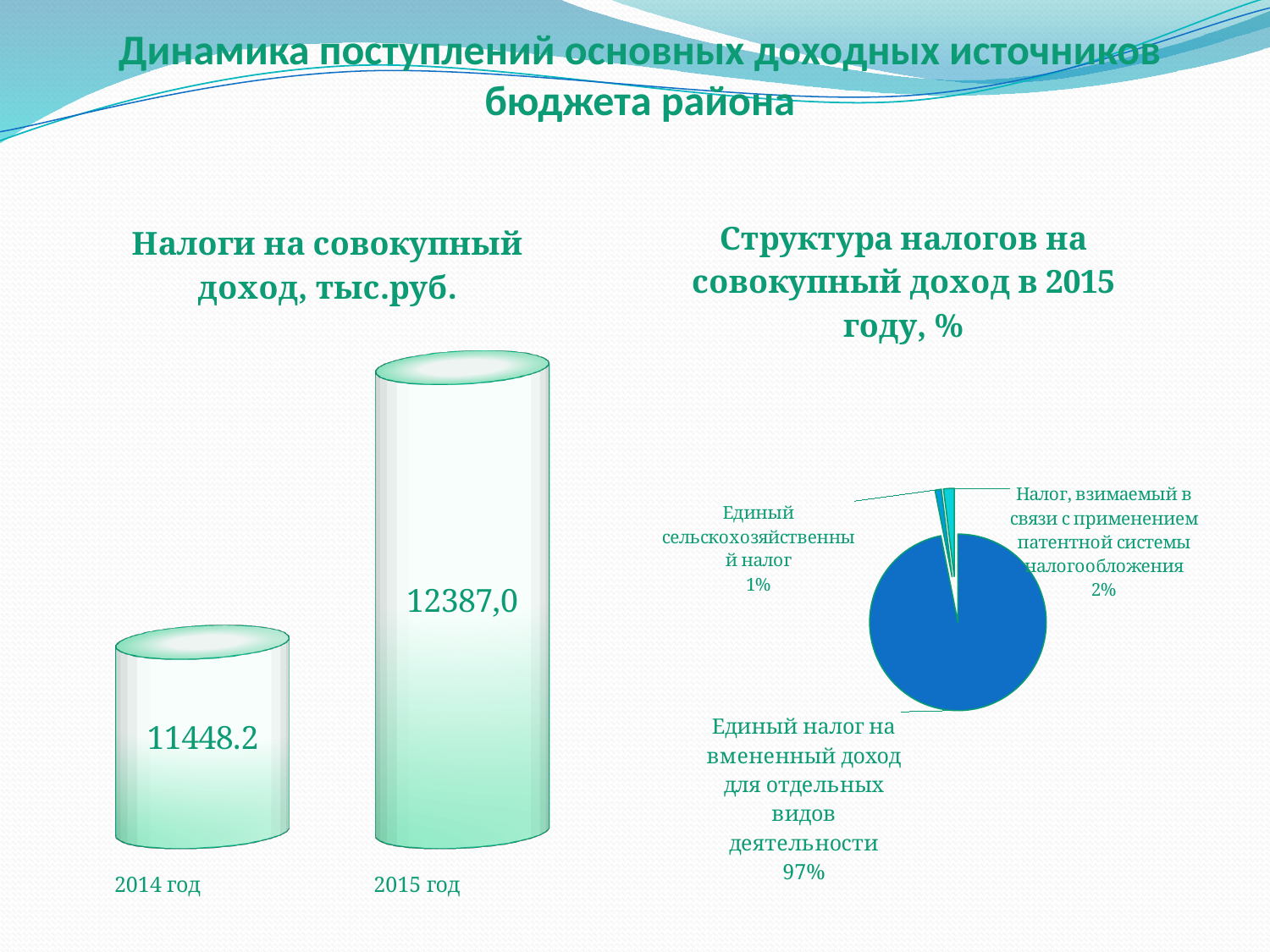
In the chart titled 'Налоги на совокупный доход, тыс.руб.', what is the value for 2015 год? 12387,0 What kind of chart is the one titled 'Структура налогов на совокупный доход в 2015 году, %'? pie chart In the chart titled 'Налоги на совокупный доход, тыс.руб.', what is the value for 2014 год? 11448.2 In the chart titled 'Налоги на совокупный доход, тыс.руб.', how many categories are shown? 2 In the chart titled 'Налоги на совокупный доход, тыс.руб.', which year has the higher value? 2015 год In the pie chart titled 'Структура налогов на совокупный доход в 2015 году, %', how many slices are there? 3 In the pie chart titled 'Структура налогов на совокупный доход в 2015 году, %', what share does 'Налог, взимаемый в связи с применением патентной системы налогообложения' have? 2% In the pie chart titled 'Структура налогов на совокупный доход в 2015 году, %', what share does 'Единый сельскохозяйственный налог' have? 1% What kind of chart is the one titled 'Налоги на совокупный доход, тыс.руб.'? bar chart In the pie chart titled 'Структура налогов на совокупный доход в 2015 году, %', what share does 'Единый налог на вмененный доход для отдельных видов деятельности' have? 97% In the chart titled 'Налоги на совокупный доход, тыс.руб.', do the values rise or fall from 2014 to 2015? rise In the chart titled 'Налоги на совокупный доход, тыс.руб.', which year has the lower value? 2014 год